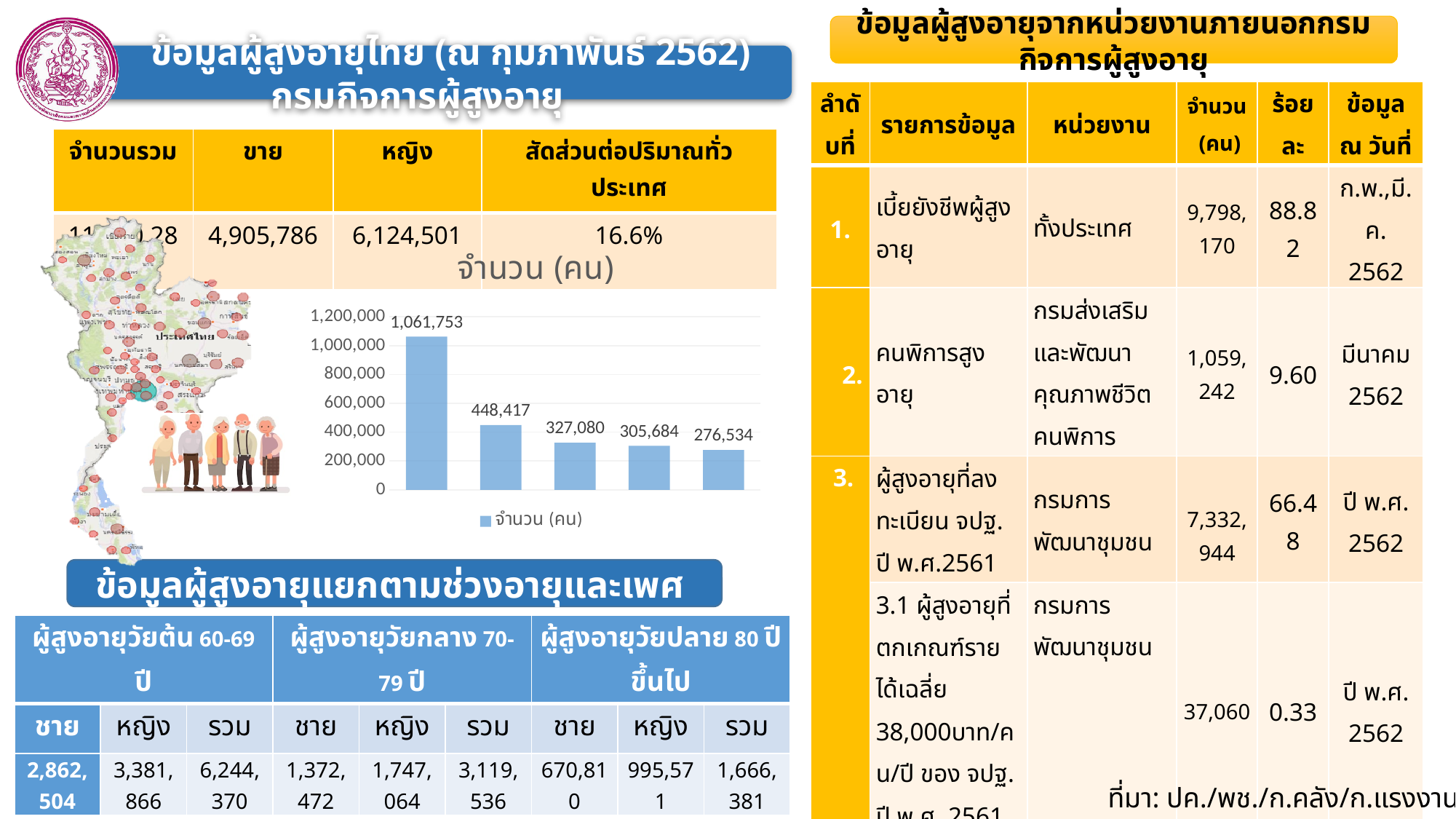
Do the bar values in the "จำนวน (คน)" chart rise or fall from left to right? fall What is the value of the shortest bar in the "จำนวน (คน)" chart? 276,534 How many bars does the "จำนวน (คน)" chart have? 5 What is the value of the tallest bar in the "จำนวน (คน)" chart? 1,061,753 How many series does the legend of the "จำนวน (คน)" chart list? 1 What is the value of the third bar from the left in the "จำนวน (คน)" chart? 327,080 What kind of chart is shown under the title "จำนวน (คน)"? bar chart What is the value of the second bar from the left in the "จำนวน (คน)" chart? 448,417 What is the legend entry shown below the "จำนวน (คน)" chart? จำนวน (คน) In the "จำนวน (คน)" chart, which is larger: the first bar or the second bar? the first bar What is the value of the fourth bar from the left in the "จำนวน (คน)" chart? 305,684 In the "จำนวน (คน)" chart, what is the difference between the first bar (1,061,753) and the second bar (448,417)? 613,336